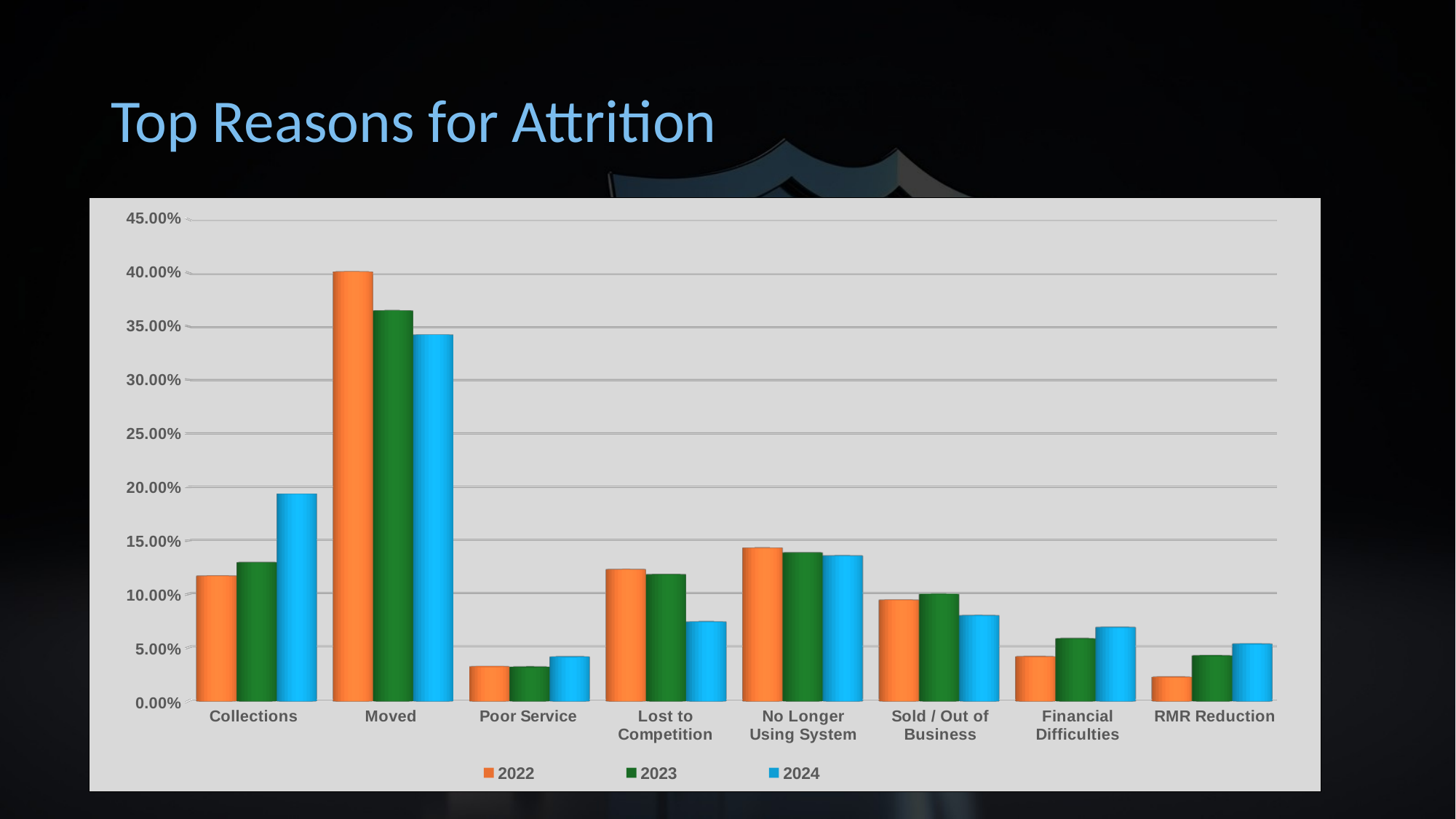
Which category has the lowest value for 2022? RMR Reduction How many series does the legend list? 3 What are the entries listed in the legend? 2022, 2023, 2024 For Collections, which year has the larger value, 2022 or 2024? 2024 Is the value for Moved in 2022 greater or less than 35.00%? greater Is the value for Lost to Competition in 2024 greater or less than 10.00%? less For Moved, which year has the larger value, 2022 or 2023? 2022 Do the values for Moved rise or fall from 2022 to 2024? fall What kind of chart is shown on the slide? bar chart How many attrition reason categories are shown on the x axis? 8 Which category has the highest value for 2022? Moved Is the value for Collections in 2024 greater or less than 15.00%? greater